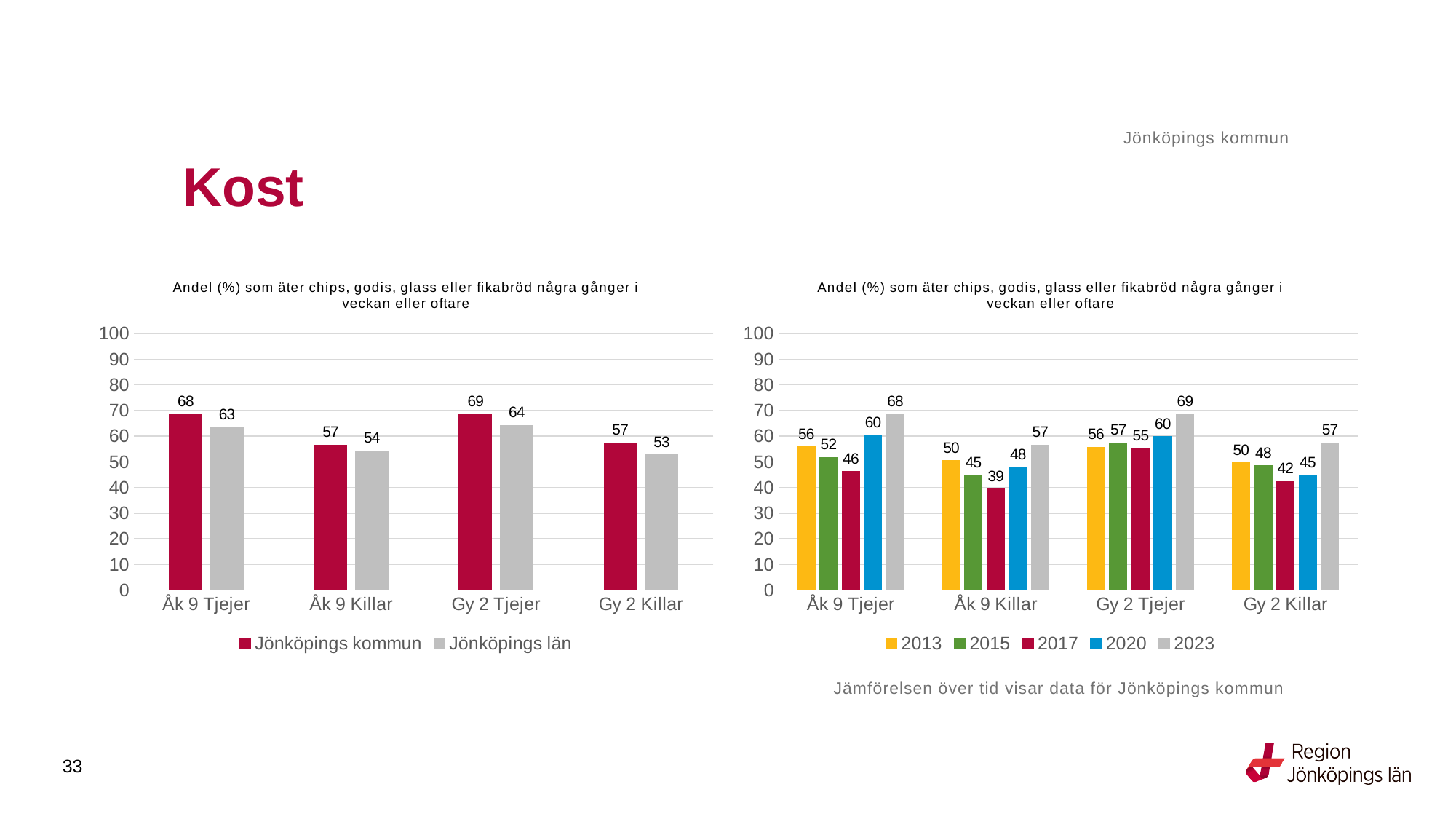
In the right chart, what is the value for 2023 for Gy 2 Tjejer? 69 In the left chart, which category has the lowest value for Jönköpings län? Gy 2 Killar In the right chart, what is the value for 2017 for Åk 9 Killar? 39 What kind of chart is the right chart? Bar chart How many series does the legend of the left chart list? 2 In the right chart, what is the difference between the 2023 and 2013 values for Åk 9 Killar? 7 How many series does the legend of the right chart list? 5 In the right chart, which is larger for Gy 2 Killar: the value for 2013 or the value for 2020? 2013 In the left chart, what is the value for Jönköpings län for Gy 2 Killar? 53 In the left chart, what is the difference between Jönköpings kommun and Jönköpings län for Gy 2 Tjejer? 5 In the left chart, what is the value for Jönköpings kommun for Åk 9 Tjejer? 68 In the right chart, which year has the highest value for Åk 9 Tjejer? 2023